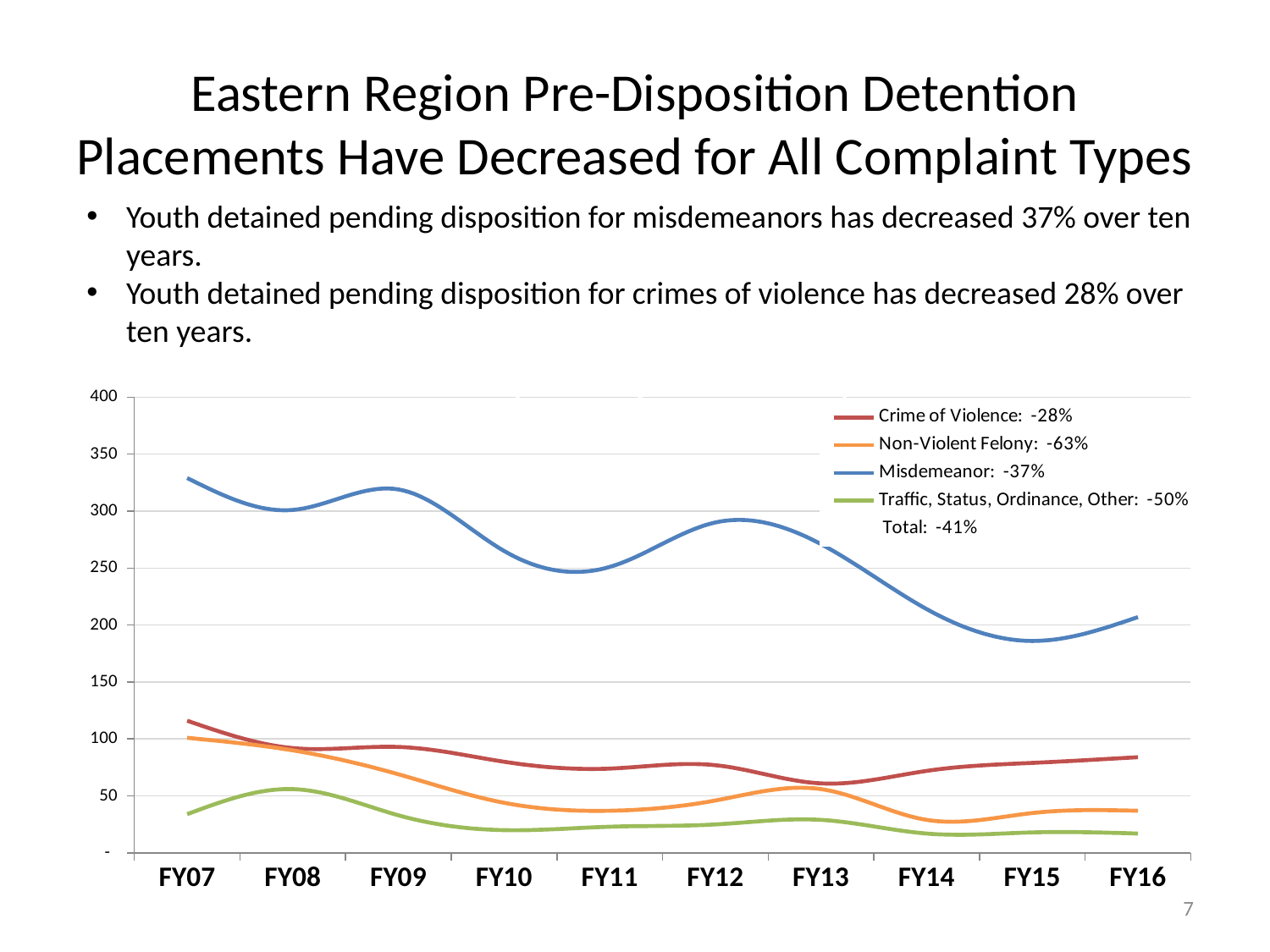
How many fiscal years are plotted along the x axis? 10 In which fiscal year is the Misdemeanor line at its lowest? FY15 Is the Misdemeanor value for FY15 greater or less than 200? less Is the Crime of Violence value for FY07 greater or less than 100? greater In FY16, which is larger: Crime of Violence or Non-Violent Felony? Crime of Violence Which series has the lowest values across all years? Traffic, Status, Ordinance, Other Is the Non-Violent Felony value for FY16 greater or less than 50? less How many series are drawn as lines in the chart? 4 What percentage change does the legend show for Non-Violent Felony? -63% Which series has the highest values across all years? Misdemeanor What kind of chart is shown on the slide? line chart